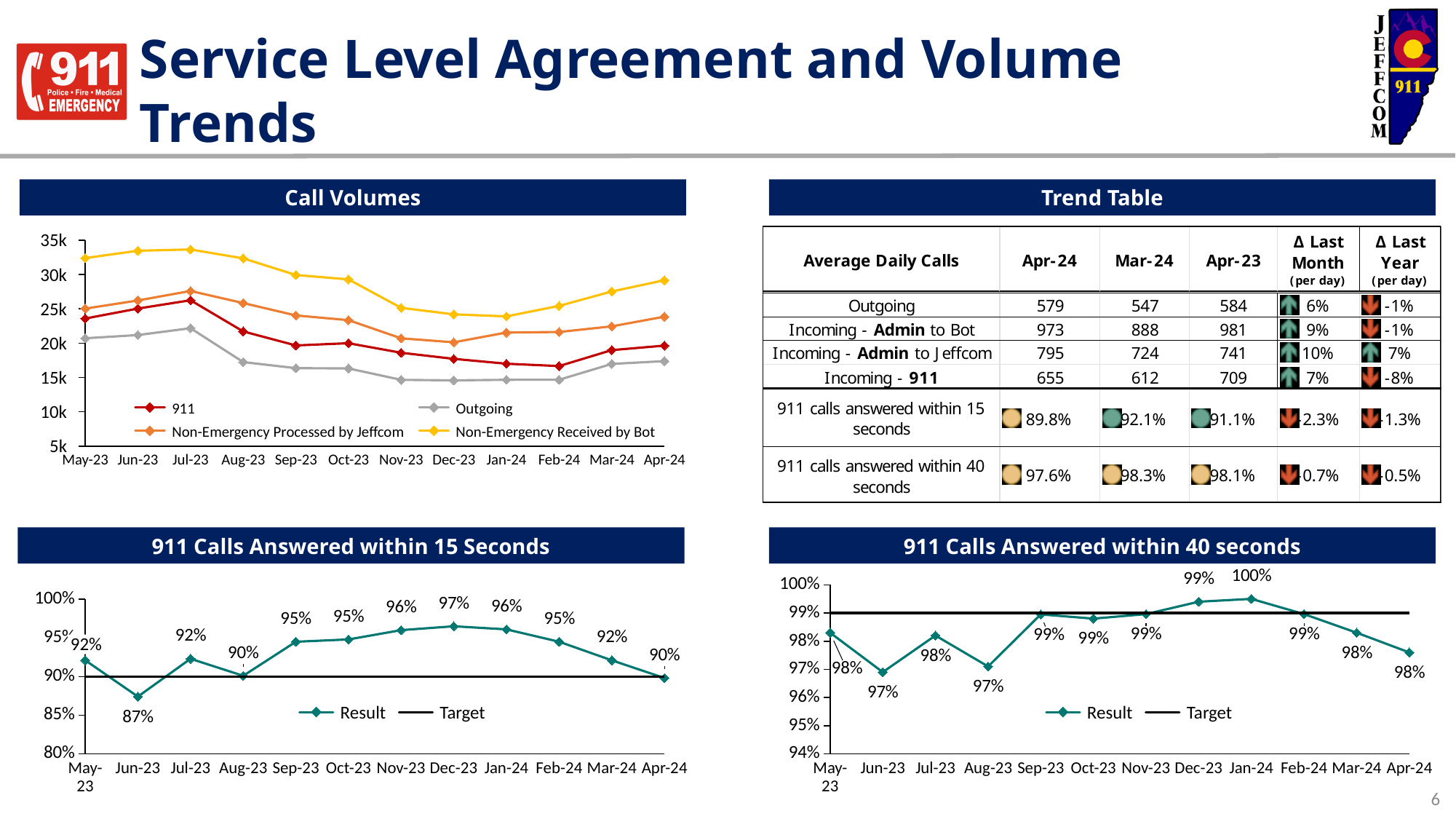
What kind of chart is the Call Volumes chart? Line chart On the Call Volumes chart, is the value for 911 in Feb-24 greater or less than 20k? less On the 911 Calls Answered within 15 Seconds chart, which month has the lowest Result? Jun-23 On the 911 Calls Answered within 40 seconds chart, what is the Result for Apr-24? 98% On the 911 Calls Answered within 15 Seconds chart, what is the Result for Dec-23? 97% On the 911 Calls Answered within 40 seconds chart, which month has the highest Result? Jan-24 On the Call Volumes chart, which series has the highest values across the months shown? Non-Emergency Received by Bot On the 911 Calls Answered within 15 Seconds chart, what is the difference between the Result for Dec-23 and the Result for Jun-23? 10 percentage points On the Call Volumes chart, is the value for Non-Emergency Received by Bot in Jul-23 greater or less than 30k? greater On the Call Volumes chart, how many series does the legend list? 4 On the Call Volumes chart, does the Non-Emergency Received by Bot line rise or fall from Jul-23 to Jan-24? Fall On the 911 Calls Answered within 15 Seconds chart, how many months are plotted on the x axis? 12